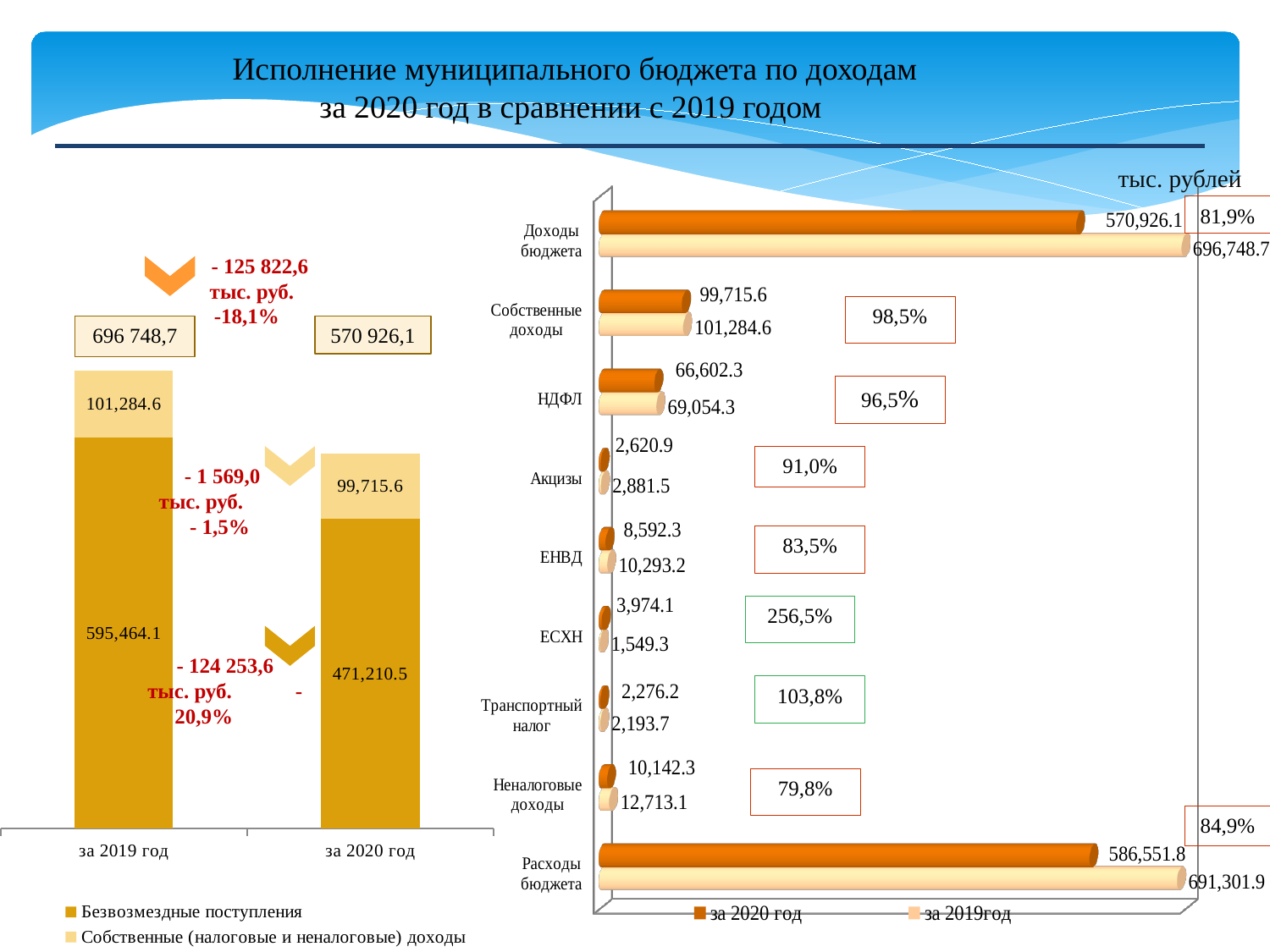
In the chart on the right, what is the value for Неналоговые доходы for the series 'за 2019год'? 12,713.1 In the chart on the left, what is the total of the stacked bar for 'за 2019 год'? 696,748.7 What type of chart is the chart on the right? bar chart How many categories are shown in the chart on the right? 9 How many series does the legend of the chart on the left list? 2 In the chart on the right, which category has the highest value for the series 'за 2020 год'? Расходы бюджета In the chart on the right, what is the difference between the 2019 and 2020 values for ЕНВД? 1,700.9 In the chart on the right, which category has the lowest value for the series 'за 2019год'? ЕСХН In the chart on the right, what is the value for НДФЛ for the series 'за 2020 год'? 66,602.3 In the chart on the right, which is larger for ЕСХН: the value for 'за 2020 год' or 'за 2019год'? за 2020 год In the chart on the left, what is the difference between the 'Собственные (налоговые и неналоговые) доходы' values for 2019 and 2020? 1,569.0 In the chart on the left, what is the value of 'Безвозмездные поступления' for 'за 2020 год'? 471,210.5